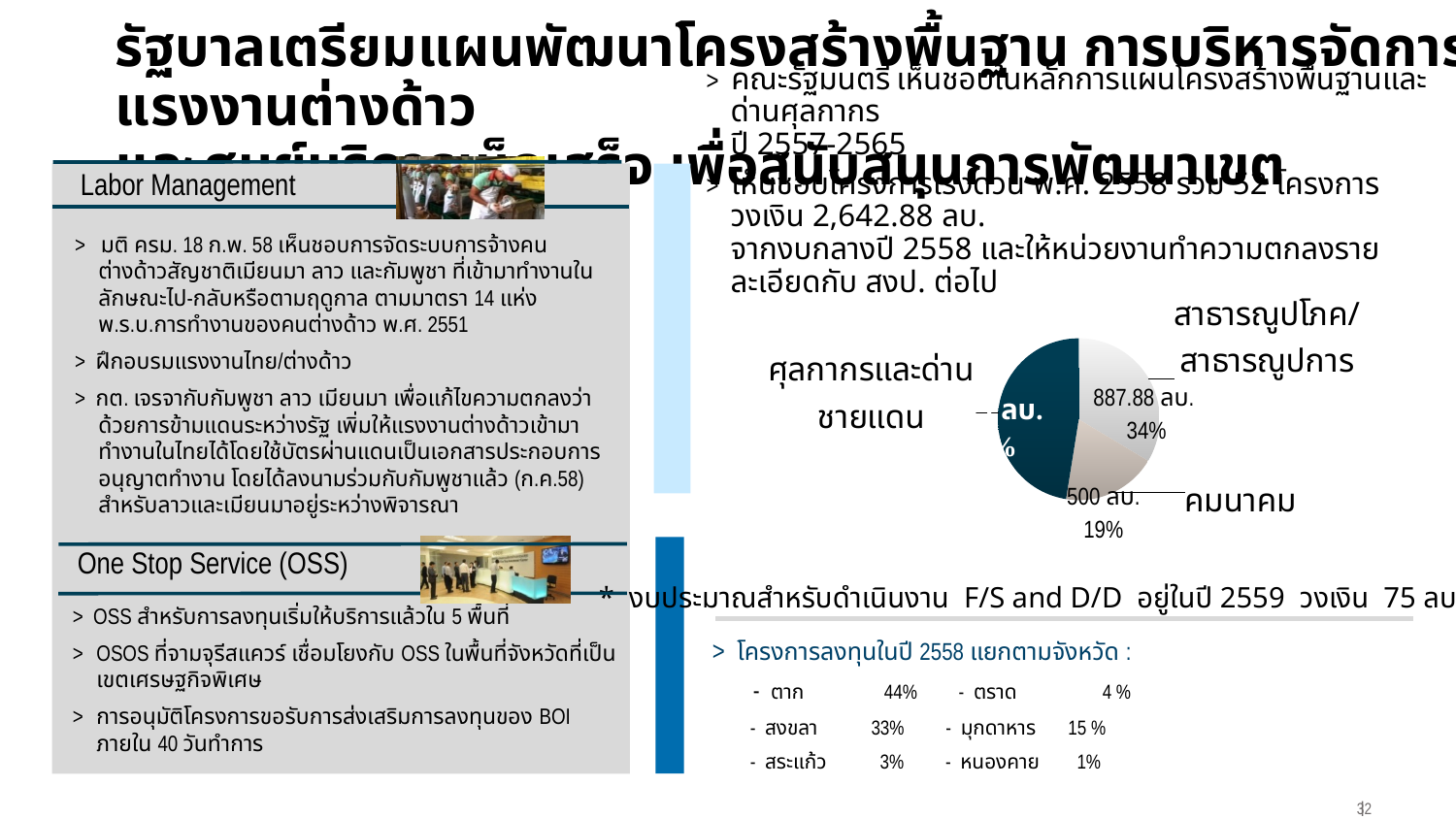
What kind of chart is shown on the slide? pie chart Which is larger in the pie chart, สาธารณูปโภค/สาธารณูปการ or คมนาคม? สาธารณูปโภค/สาธารณูปการ Which slice of the pie chart is the smallest? คมนาคม What share of the pie does the สาธารณูปโภค/สาธารณูปการ slice represent? 34% Which slice of the pie chart is the largest? ศุลกากรและด่านชายแดน What share of the pie does the คมนาคม slice represent? 19% What value is printed for the คมนาคม slice of the pie chart? 500 ลบ. What value is printed for the สาธารณูปโภค/สาธารณูปการ slice of the pie chart? 887.88 ลบ. How many slices does the pie chart have? 3 Which slice of the pie chart is coloured dark teal? ศุลกากรและด่านชายแดน What is the difference in value between the สาธารณูปโภค/สาธารณูปการ slice and the คมนาคม slice? 387.88 ลบ. By how many percentage points does the share of สาธารณูปโภค/สาธารณูปการ exceed the share of คมนาคม? 15%